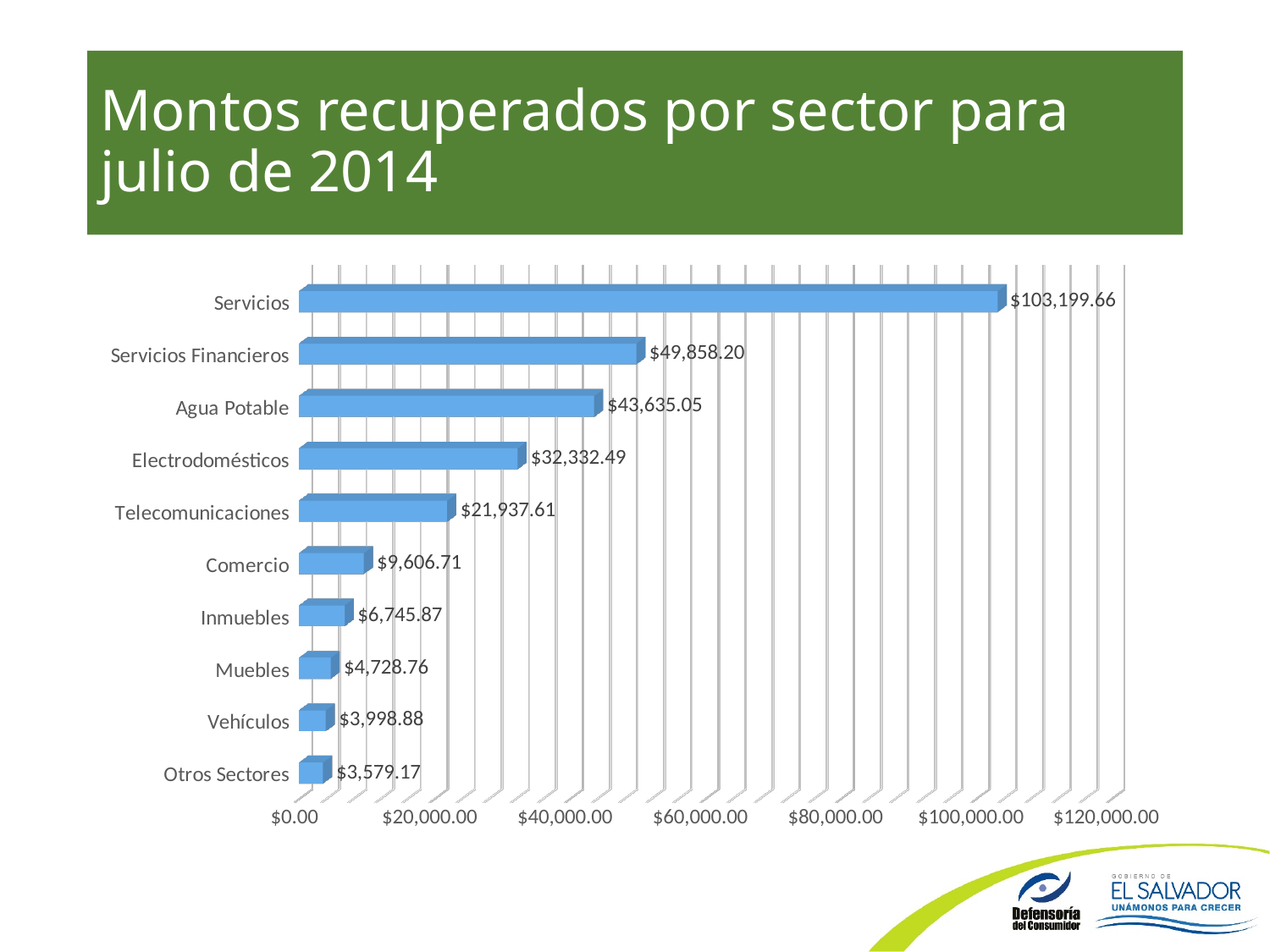
Which sector has the highest recovered amount? Servicios What is the value for Telecomunicaciones? $21,937.61 Which sector has the lowest recovered amount? Otros Sectores How many sectors are shown in the chart? 10 What is the difference between Servicios and Servicios Financieros? $53,341.46 What is the value for Agua Potable? $43,635.05 What kind of chart is shown on the slide? Bar chart What is the value for Vehículos? $3,998.88 What is the value for Servicios? $103,199.66 What is the difference between Servicios Financieros and Agua Potable? $6,223.15 Which is larger, Electrodomésticos or Comercio? Electrodomésticos What is the title of the slide? Montos recuperados por sector para julio de 2014